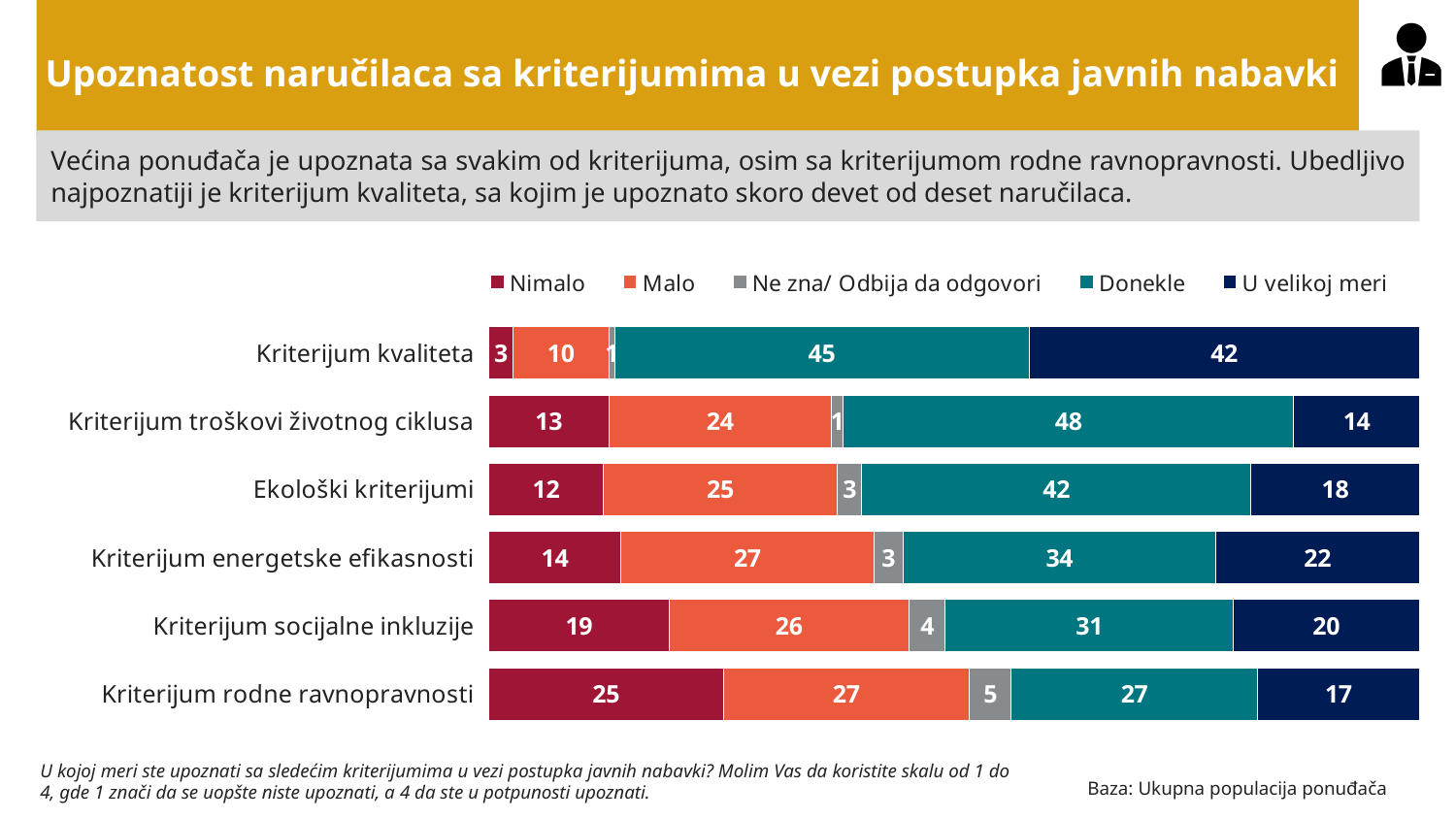
What is the value of "Donekle" for Kriterijum kvaliteta? 45 Which legend entry is shown in grey? Ne zna/ Odbija da odgovori What is the difference between the "Donekle" values for Kriterijum troškovi životnog ciklusa and Kriterijum socijalne inkluzije? 17 What is the value of "U velikoj meri" for Kriterijum troškovi životnog ciklusa? 14 Which criterion has the highest "U velikoj meri" value? Kriterijum kvaliteta How many series does the legend list? 5 How many criteria (categories) are shown in the chart? 6 Which is larger: the "Malo" value for Ekološki kriterijumi or the "Malo" value for Kriterijum energetske efikasnosti? Kriterijum energetske efikasnosti What is the value of "Nimalo" for Kriterijum rodne ravnopravnosti? 25 What is the total of the stacked bar for Kriterijum energetske efikasnosti? 100 Which criterion has the lowest "Nimalo" value? Kriterijum kvaliteta What kind of chart is shown on the slide? Stacked bar chart